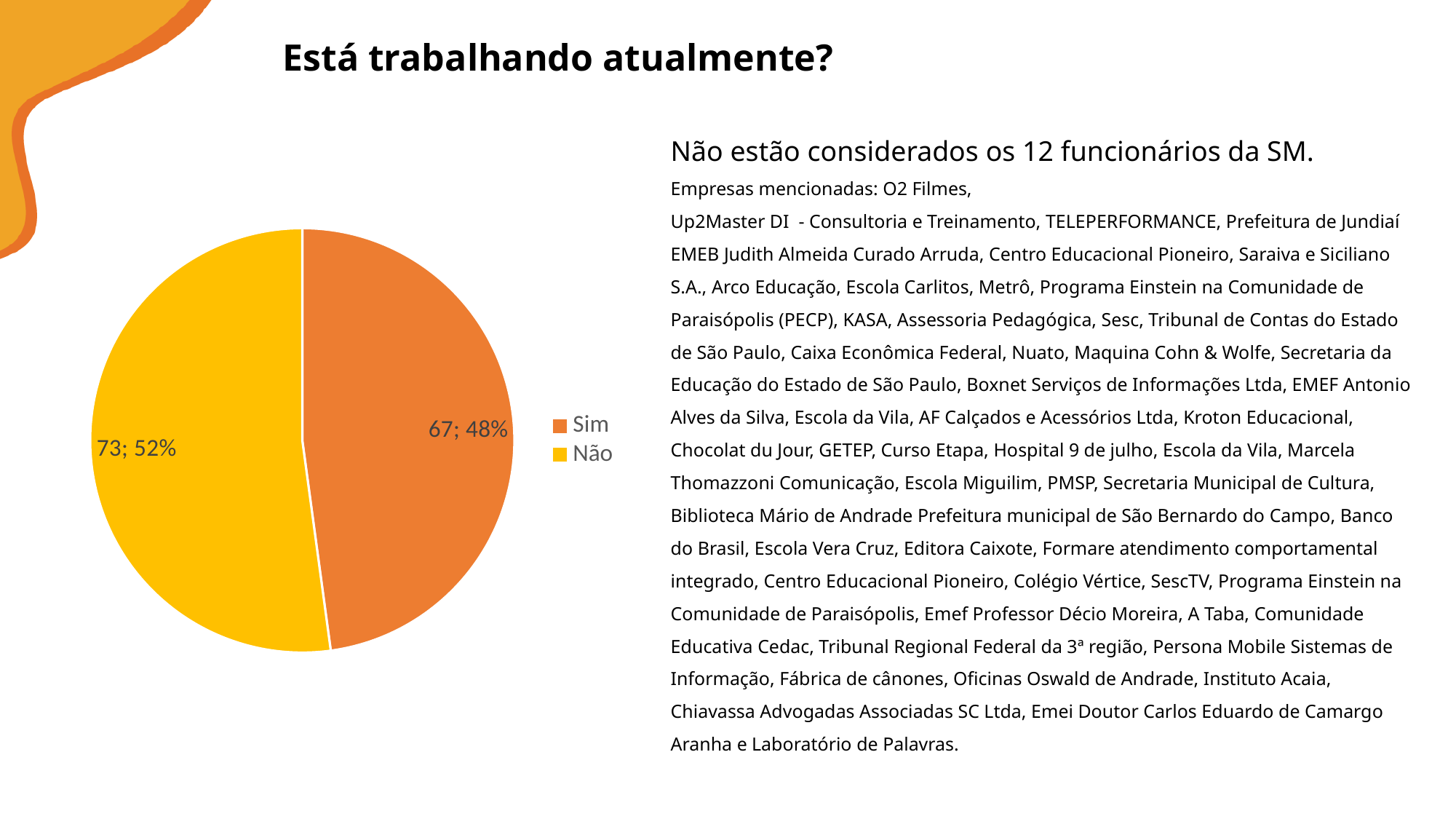
What percentage share does the "Não" slice have? 52% What colour is the "Sim" slice? orange What is the count shown for the "Não" slice? 73 What kind of chart is shown on the slide? pie chart Which slice is larger, "Sim" or "Não"? Não What percentage share does the "Sim" slice have? 48% Which category has the smallest slice? Sim What is the difference between the counts for "Não" and "Sim"? 6 What is the count shown for the "Sim" slice? 67 How many slices does the pie chart have? 2 How many entries does the legend list? 2 What is the total of the two slice counts? 140